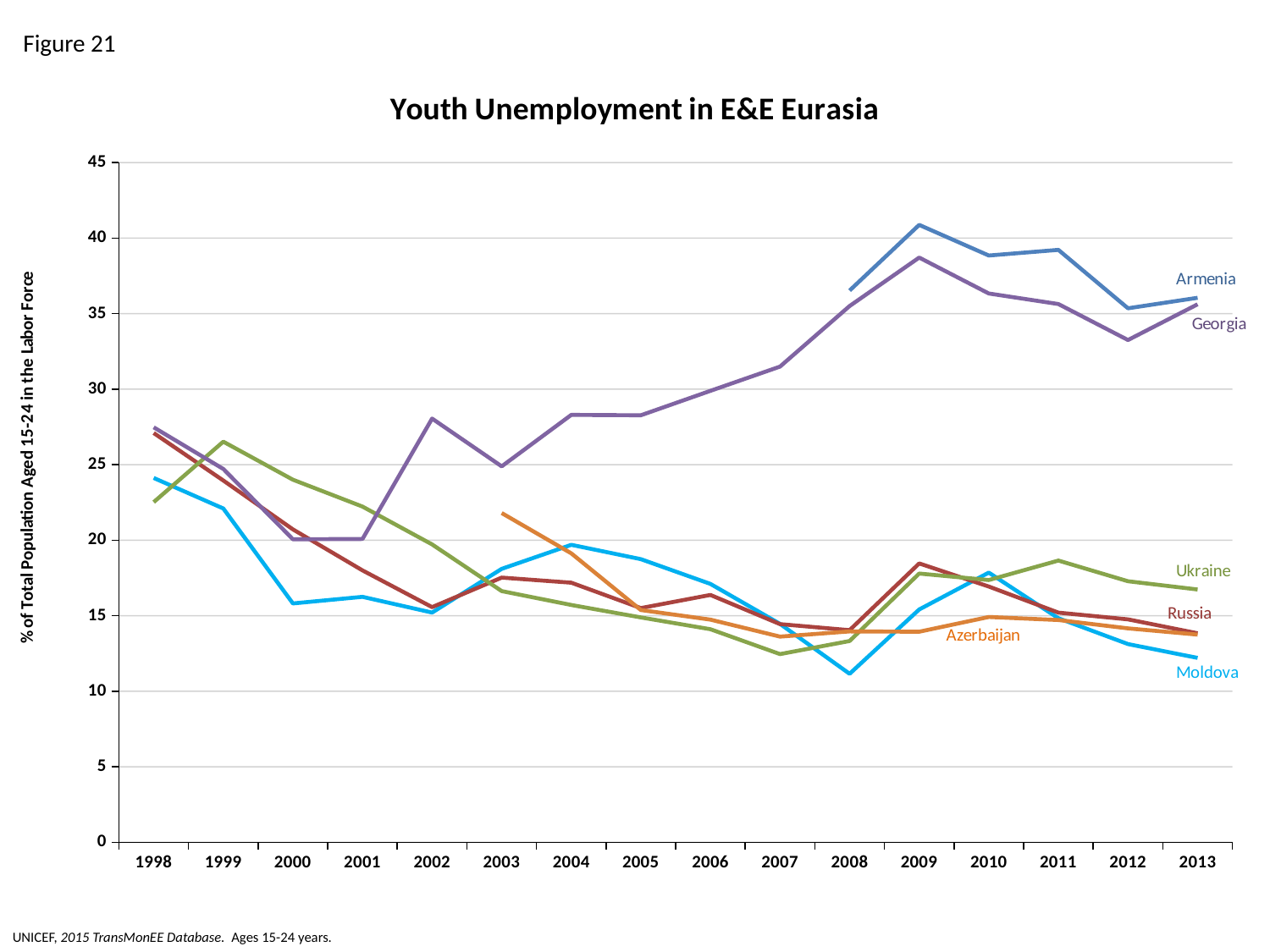
Does the line for Ukraine rise or fall overall from 1999 to 2007? Fall In 2012, which country has the larger value, Armenia or Georgia? Armenia How many years are shown along the x axis of the chart? 16 Which country has the lowest youth unemployment value in 2013? Moldova What type of chart is shown on the slide? Line chart Which country has the highest youth unemployment value in 2013? Armenia Is the value for Armenia in 2009 greater or less than 40? greater How many countries are plotted as lines in the chart? 6 Is the value for Georgia in 2002 greater or less than 25? greater What is the label on the y axis of the chart? % of Total Population Aged 15-24 in the Labor Force What is the title of the chart? Youth Unemployment in E&E Eurasia Is the value for Moldova in 2008 greater or less than 15? less